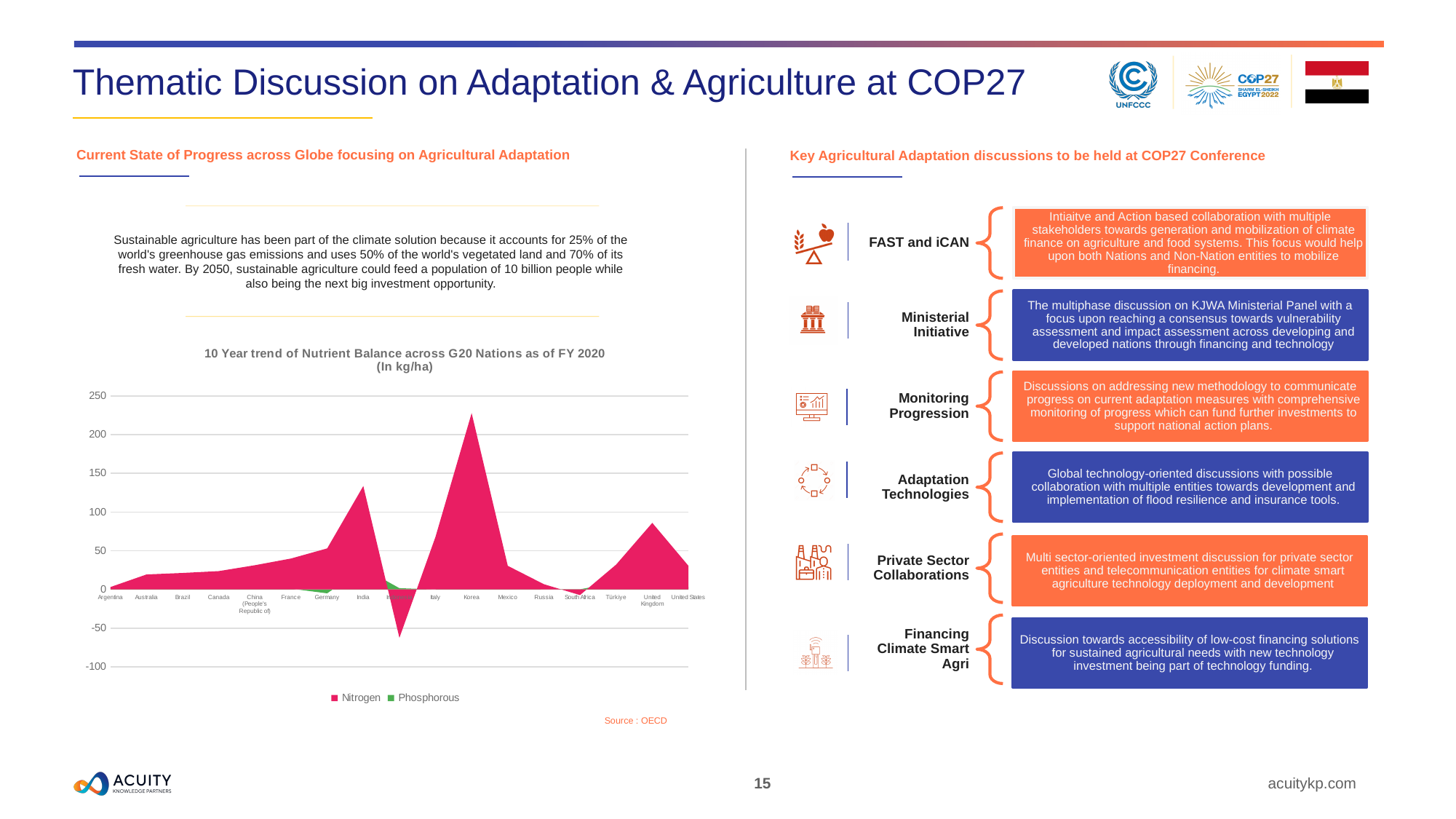
Which has a larger Nitrogen value, United Kingdom or Mexico? United Kingdom What kind of chart is shown on the slide? Area chart Is the Nitrogen value for Mexico greater or less than 50? less Is the Nitrogen value for India greater or less than 100? greater What is the title of the chart? 10 Year trend of Nutrient Balance across G20 Nations as of FY 2020 (In kg/ha) Which has a larger Nitrogen value, Korea or India? Korea Is the Nitrogen value for Korea greater or less than 200? greater How many countries are plotted along the x axis of the chart? 17 Which country has the highest Nitrogen value in the chart? Korea What are the two series named in the chart legend? Nitrogen and Phosphorous How many series does the chart legend list? 2